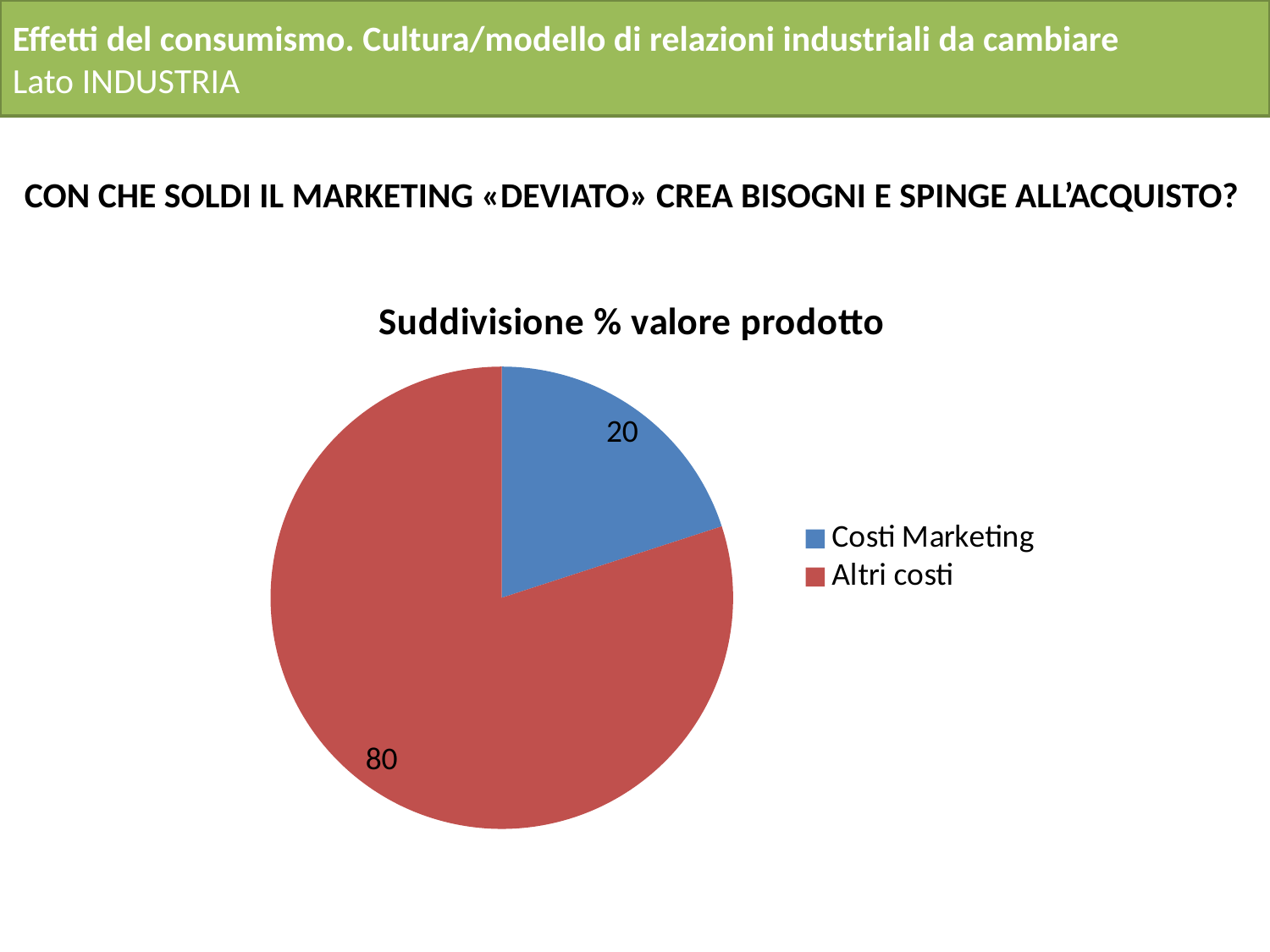
How many slices does the pie chart have? 2 What is the difference between the values for Altri costi and Costi Marketing? 60 What is the value for Costi Marketing? 20 Which is larger, Costi Marketing or Altri costi? Altri costi What share of the pie does Costi Marketing represent? 20% Which slice is the smallest? Costi Marketing What is the value for Altri costi? 80 What kind of chart is shown on the slide? pie chart What colour is the Altri costi slice? red Which slice is the largest? Altri costi What is the title of the chart? Suddivisione % valore prodotto How many entries does the legend list? 2